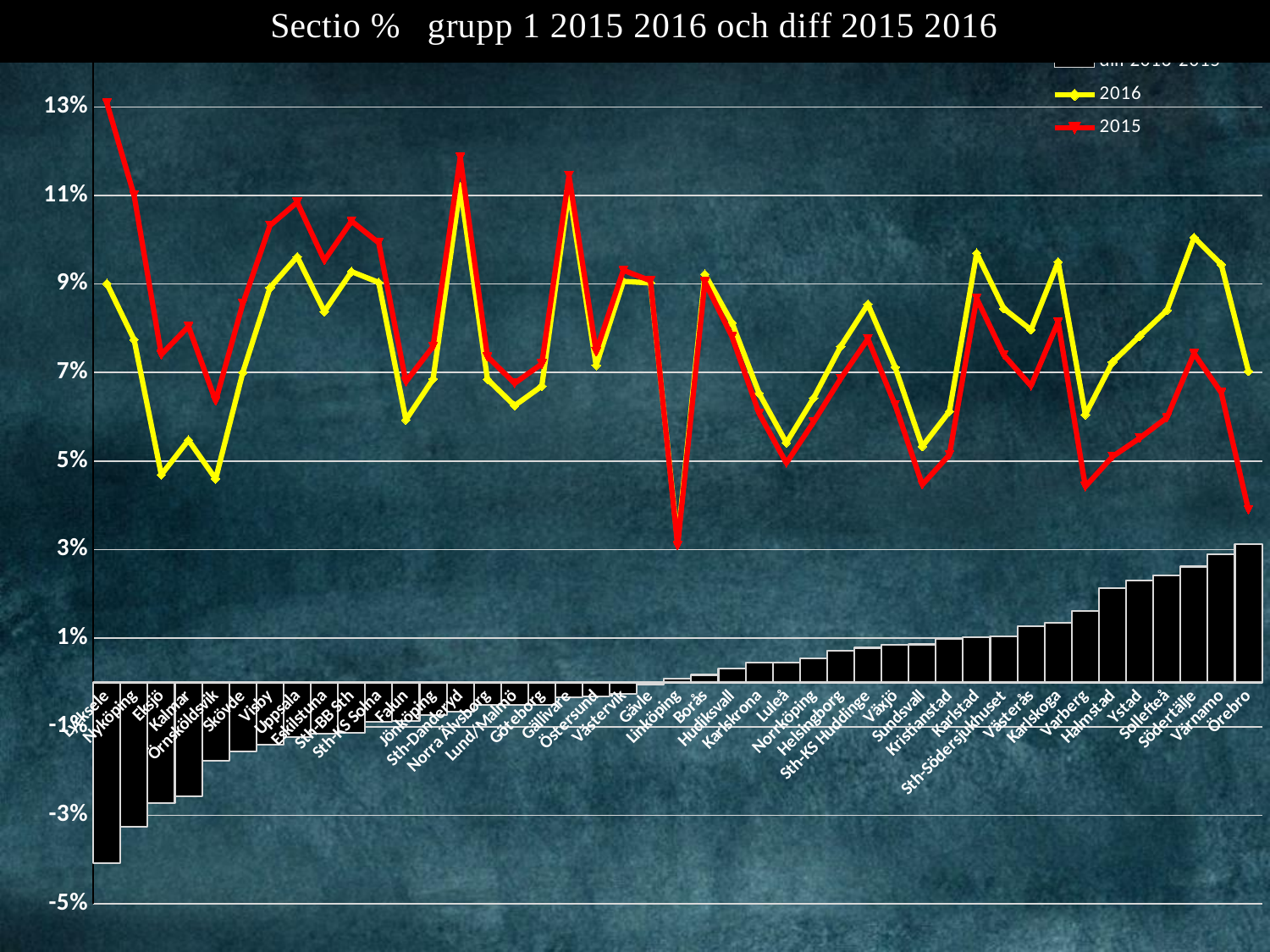
Which category has the lowest (most negative) diff bar? Lycksele Do the diff bars rise or fall from left to right along the x axis? rise For Örebro, which is larger, the 2015 value or the 2016 value? 2016 Which category has the lowest 2015 value? Linköping Is the 2015 value for Linköping greater or less than 5%? less Which category has the highest 2015 value? Lycksele Is the 2015 value for Lycksele greater or less than 11%? greater Is the 2016 value for Sth-Danderyd greater or less than 11%? greater Which series is drawn in red? 2015 How many series does the legend list? 3 What kind of chart is shown on the slide? A combination of line and bar chart Which category has the highest diff bar? Örebro